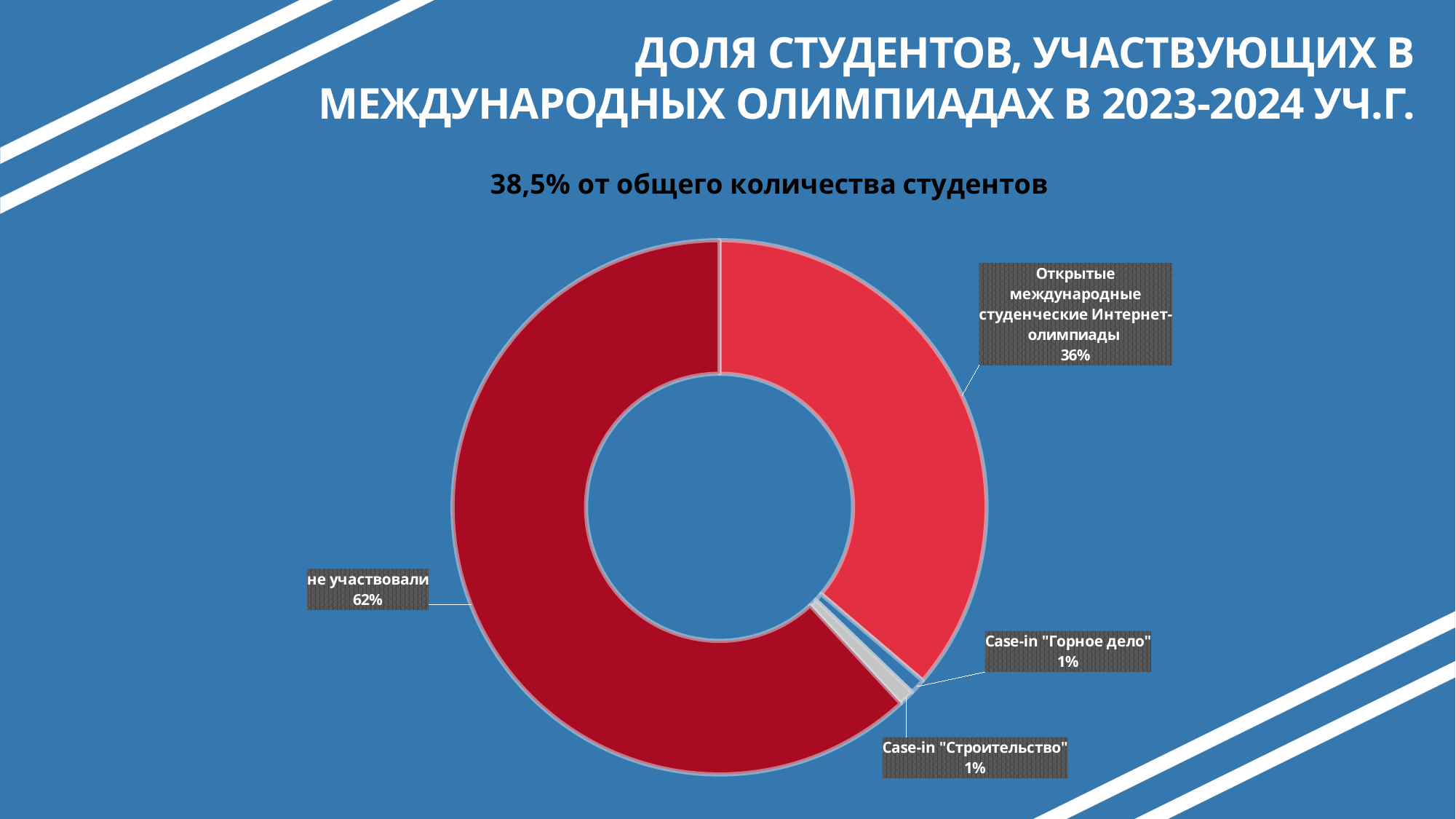
What is the combined share of the two Case-in categories? 2% What is the title printed directly above the chart? 38,5% от общего количества студентов Which is larger: the slice for "не участвовали" or the slice for "Открытые международные студенческие Интернет-олимпиады"? не участвовали What share of students did not participate ("не участвовали")? 62% What share of students took part in "Открытые международные студенческие Интернет-олимпиады"? 36% How many slices does the chart have? 4 What is the difference in percentage points between "не участвовали" (62%) and "Открытые международные студенческие Интернет-олимпиады" (36%)? 26 percentage points Which category has the largest slice of the chart? не участвовали Which academic year does the slide title refer to? 2023-2024 уч.г. What share is shown for Case-in "Горное дело"? 1% What share is shown for Case-in "Строительство"? 1% What kind of chart is shown on the slide? Pie chart (doughnut)